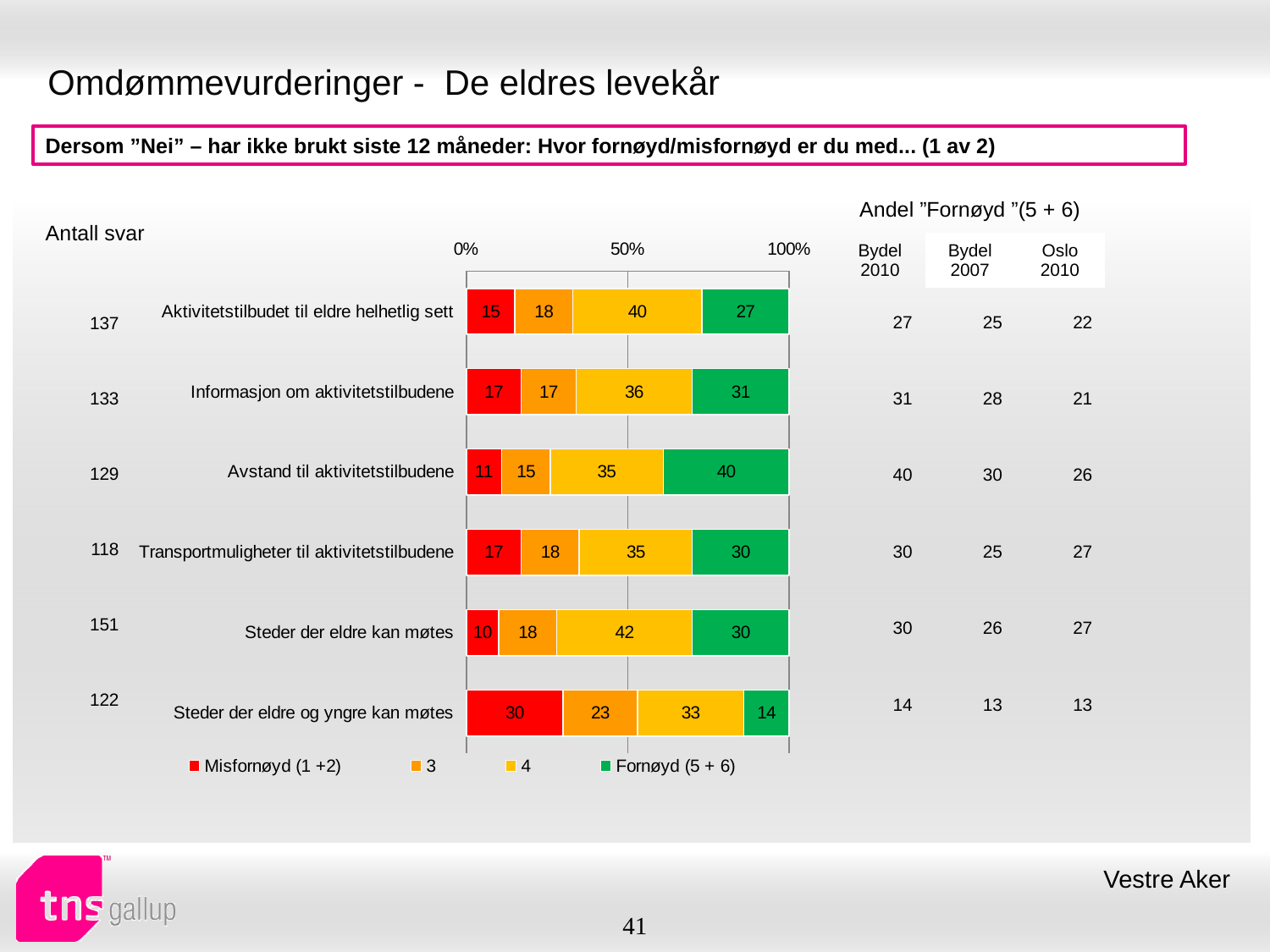
What is the value of the '4' segment for 'Steder der eldre kan møtes'? 42 Which colour represents the 'Fornøyd (5 + 6)' series in the chart? green What is the value of the 'Fornøyd (5 + 6)' segment for 'Avstand til aktivitetstilbudene'? 40 How many series does the chart legend list? 4 What is the total of the stacked bar for 'Aktivitetstilbudet til eldre helhetlig sett'? 100 Which category has the highest 'Fornøyd (5 + 6)' value? Avstand til aktivitetstilbudene What is the difference between the 'Fornøyd (5 + 6)' values for 'Avstand til aktivitetstilbudene' and 'Steder der eldre og yngre kan møtes'? 26 What is the value of the 'Misfornøyd (1 +2)' segment for 'Steder der eldre og yngre kan møtes'? 30 Which category has the lowest 'Fornøyd (5 + 6)' value? Steder der eldre og yngre kan møtes Which is larger: the 'Misfornøyd (1 +2)' value for 'Informasjon om aktivitetstilbudene' or for 'Steder der eldre kan møtes'? Informasjon om aktivitetstilbudene What kind of chart is shown on the slide? stacked bar chart How many categories are plotted in the chart? 6